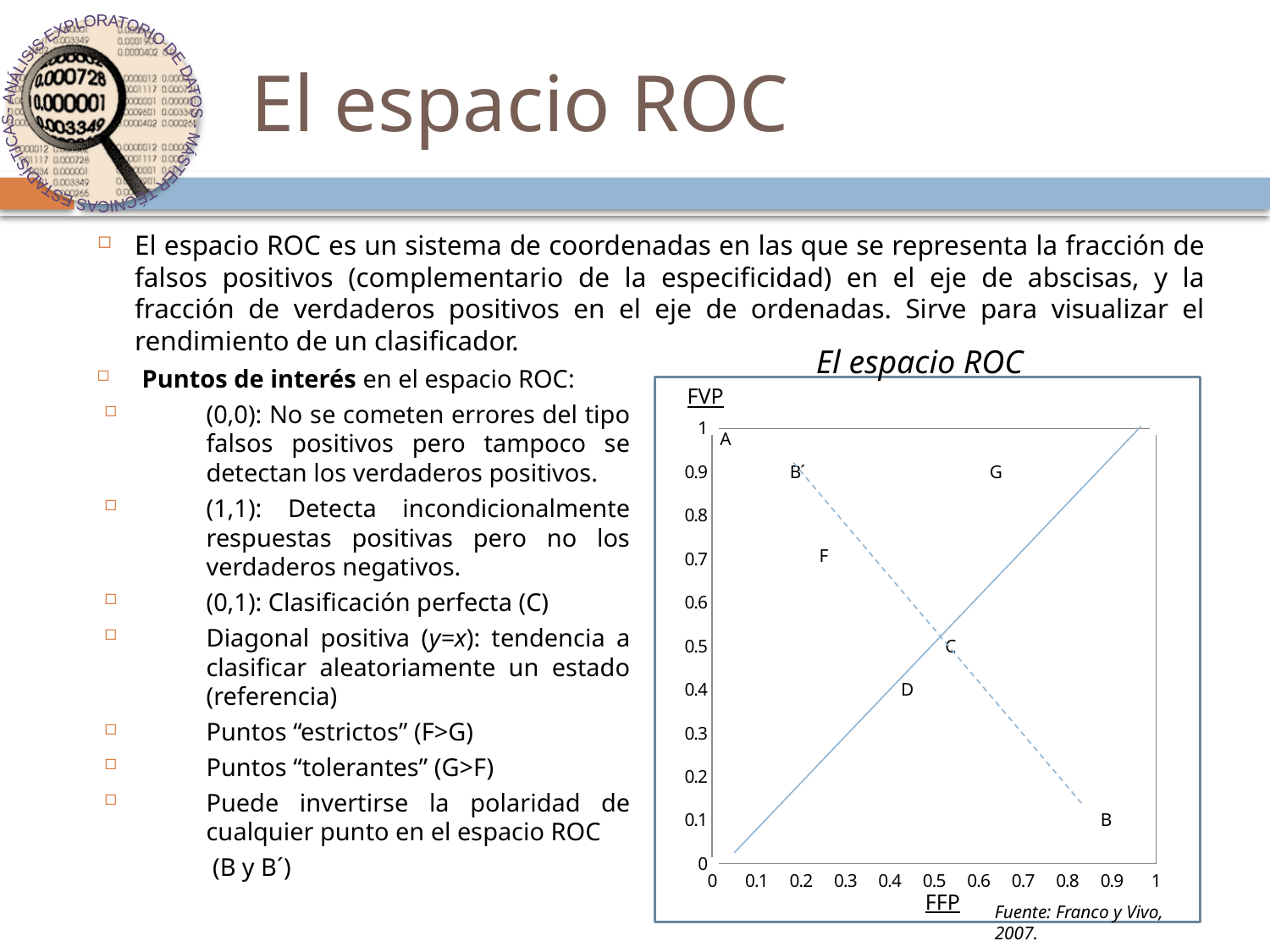
Which labeled point has the highest FVP value? A Which labeled point has the highest FFP value? B What kind of chart is shown on the slide? scatter chart Which labeled point has the lowest FVP value? B Is the FVP value for point G greater or less than 0.5? greater Is the FFP value for point B greater or less than 0.5? greater What label is shown on the vertical axis of the chart? FVP How many labeled points are plotted in the chart? 7 What is the title of the chart? El espacio ROC Which point has a higher FVP value, G or B? G Is the FVP value for point B greater or less than 0.5? less Does the solid diagonal line rise or fall as FFP increases? rises